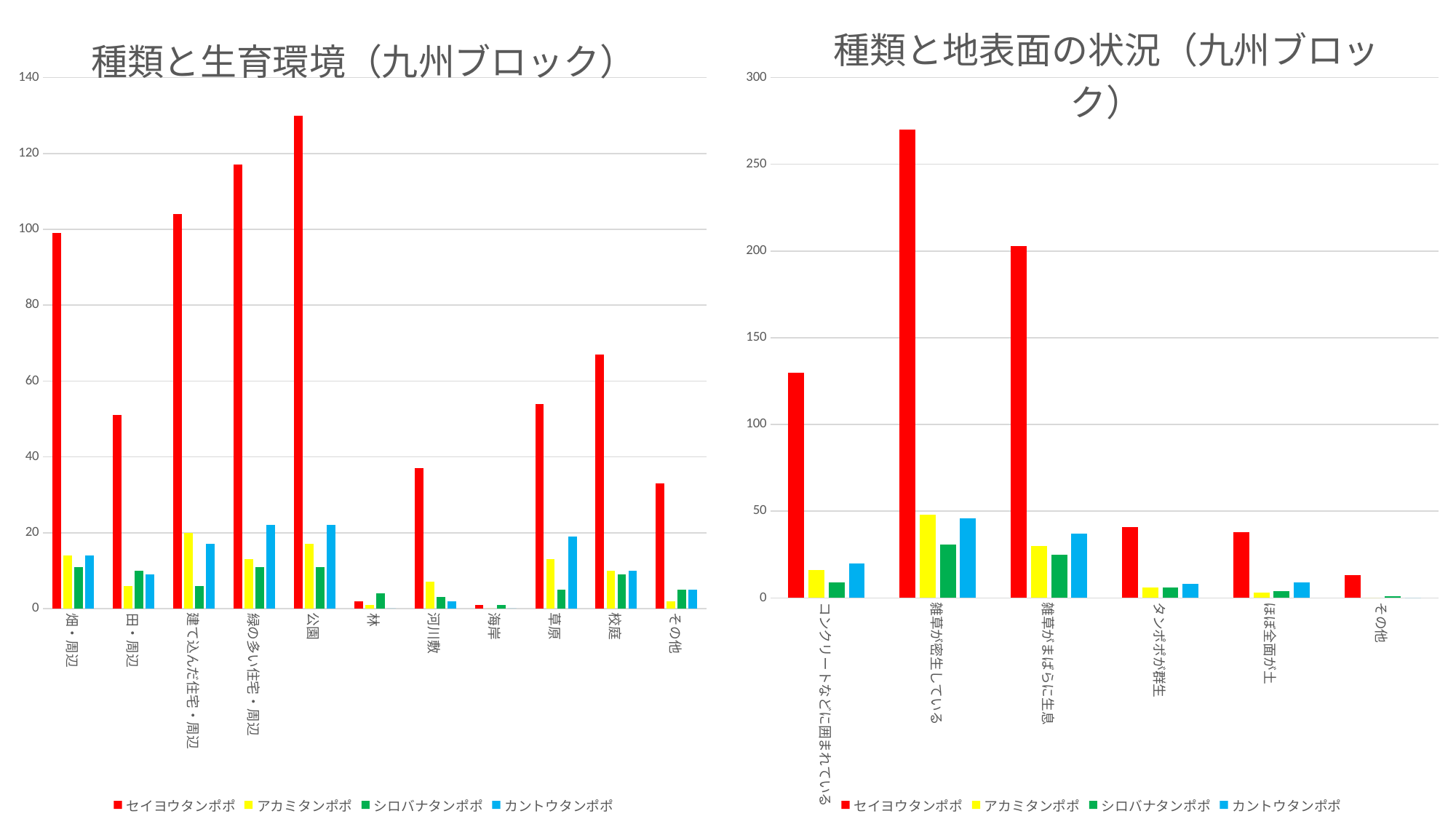
In the left chart (種類と生育環境), which category has the lowest value for セイヨウタンポポ? 海岸 In the right chart (種類と地表面の状況), is the value for セイヨウタンポポ at 雑草がまばらに生息 greater or less than 150? greater In the right chart (種類と地表面の状況), which colour represents カントウタンポポ? blue In the right chart (種類と地表面の状況), how many categories are shown on the x axis? 6 In the left chart (種類と生育環境), which category has the highest value for セイヨウタンポポ? 公園 How many series does the legend of the left chart (種類と生育環境) list? 4 In the right chart (種類と地表面の状況), which category has the highest value for セイヨウタンポポ? 雑草が密生している What kind of chart is the left chart titled 種類と生育環境（九州ブロック）? bar chart In the left chart (種類と生育環境), is the value for セイヨウタンポポ at 公園 greater or less than 120? greater In the right chart (種類と地表面の状況), which is larger for セイヨウタンポポ: 雑草が密生している or コンクリートなどに囲まれている? 雑草が密生している In the left chart (種類と生育環境), is the value for セイヨウタンポポ at 田・周辺 greater or less than 40? greater How many categories are shown on the x axis of the left chart (種類と生育環境)? 11